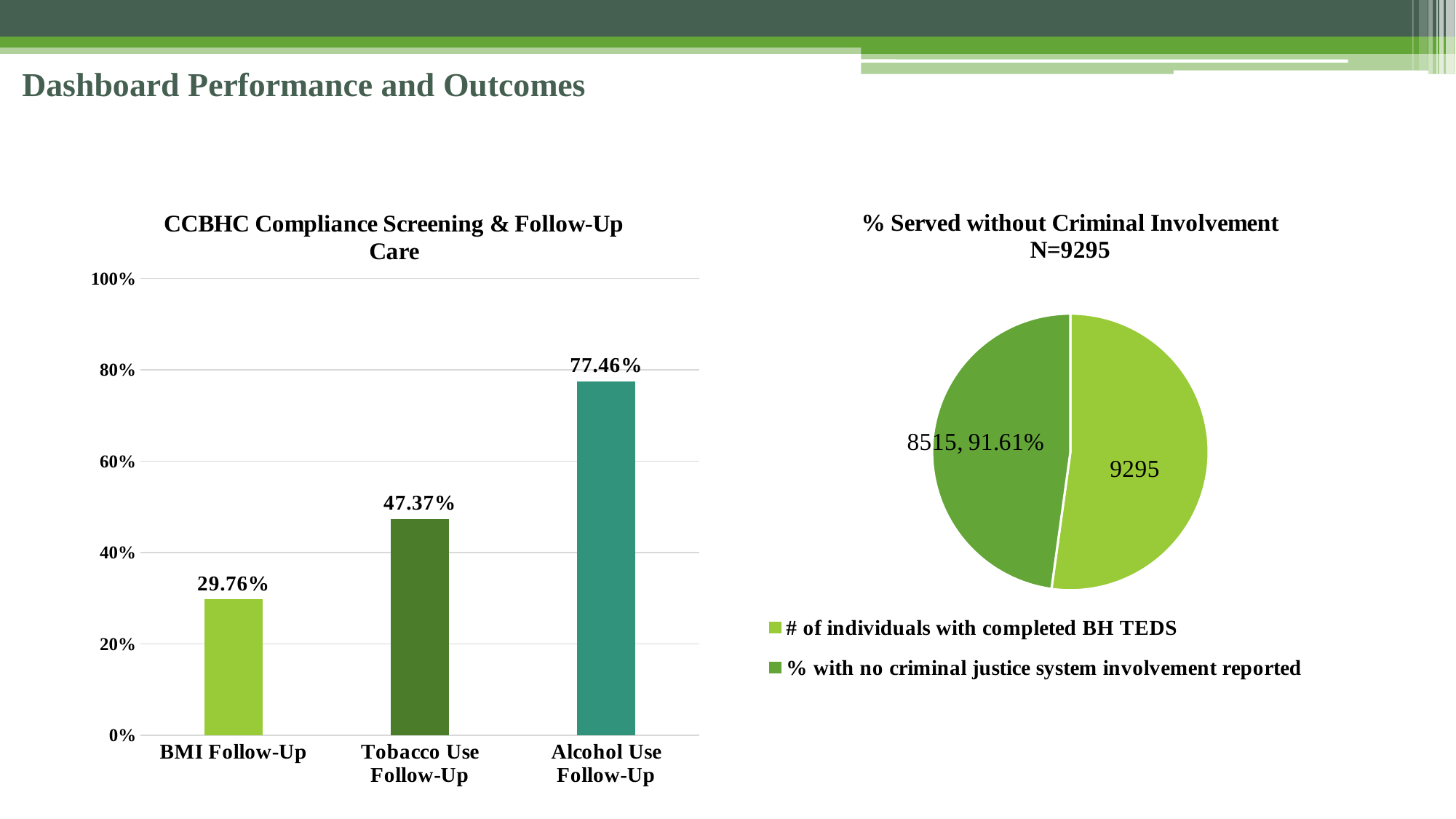
How many categories are shown in the 'CCBHC Compliance Screening & Follow-Up Care' chart? 3 What kind of chart is the '% Served without Criminal Involvement N=9295' chart? pie chart In the 'CCBHC Compliance Screening & Follow-Up Care' chart, what is the value for Alcohol Use Follow-Up? 77.46% In the 'CCBHC Compliance Screening & Follow-Up Care' chart, what is the value for BMI Follow-Up? 29.76% In the 'CCBHC Compliance Screening & Follow-Up Care' chart, which is larger: BMI Follow-Up or Tobacco Use Follow-Up? Tobacco Use Follow-Up In the 'CCBHC Compliance Screening & Follow-Up Care' chart, is the value for Tobacco Use Follow-Up greater or less than 40%? greater In the 'CCBHC Compliance Screening & Follow-Up Care' chart, which category has the highest value? Alcohol Use Follow-Up How many series does the legend of the '% Served without Criminal Involvement N=9295' chart list? 2 In the 'CCBHC Compliance Screening & Follow-Up Care' chart, what is the difference between Alcohol Use Follow-Up and Tobacco Use Follow-Up? 30.09% What kind of chart is the 'CCBHC Compliance Screening & Follow-Up Care' chart? bar chart In the 'CCBHC Compliance Screening & Follow-Up Care' chart, which category has the lowest value? BMI Follow-Up In the 'CCBHC Compliance Screening & Follow-Up Care' chart, what is the value for Tobacco Use Follow-Up? 47.37%